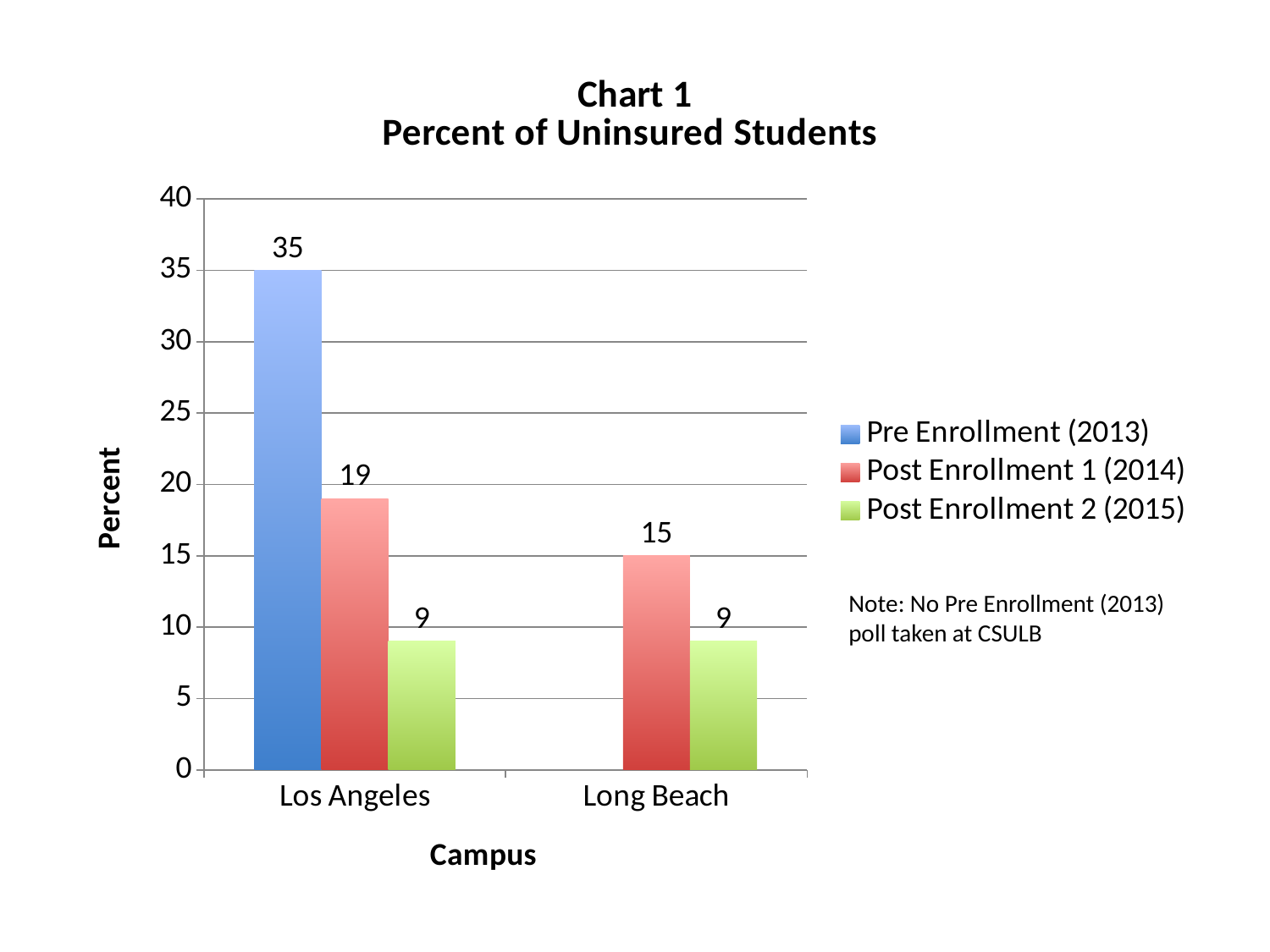
What is the title of the chart? Chart 1 Percent of Uninsured Students Which campus has the highest Post Enrollment 1 (2014) value? Los Angeles For Los Angeles, do the values rise or fall from Pre Enrollment (2013) to Post Enrollment 2 (2015)? Fall How many series does the legend list? 3 Which is larger: the Post Enrollment 1 (2014) value for Los Angeles or for Long Beach? Los Angeles What is the Pre Enrollment (2013) value for Los Angeles? 35 What is the Post Enrollment 2 (2015) value for Los Angeles? 9 What kind of chart is shown? Bar chart What is the difference between the Pre Enrollment (2013) and Post Enrollment 2 (2015) values for Los Angeles? 26 What is the Post Enrollment 1 (2014) value for Long Beach? 15 What is the difference between the Post Enrollment 1 (2014) values for Los Angeles and Long Beach? 4 How many campuses are shown on the x axis? 2